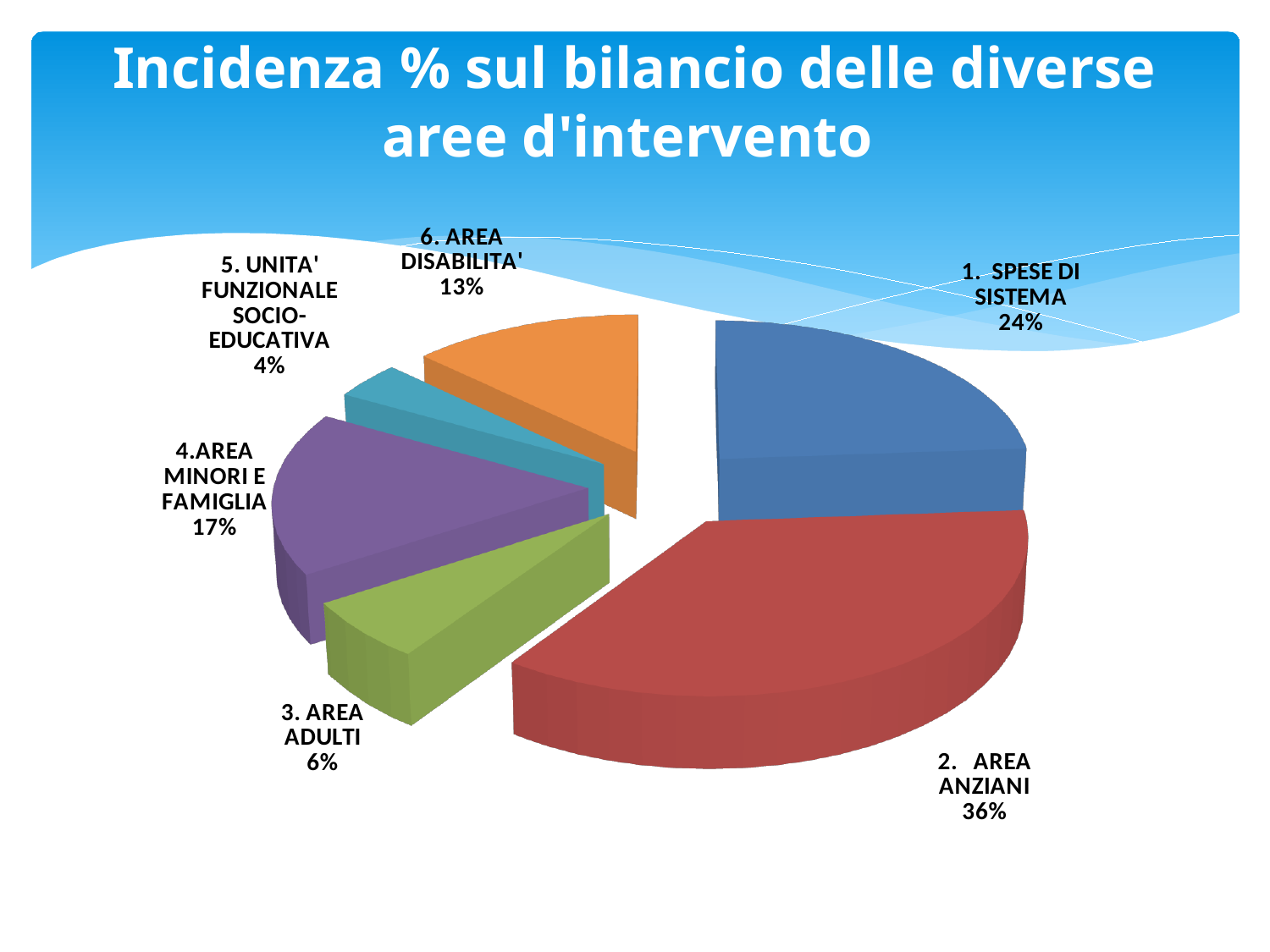
What percentage is shown for '5. UNITA' FUNZIONALE SOCIO-EDUCATIVA'? 4% What kind of chart is shown on the slide? Pie chart What percentage is shown for '4.AREA MINORI E FAMIGLIA'? 17% How many slices does the pie chart have? 6 What share of the budget does '1. SPESE DI SISTEMA' account for? 24% What is the title of the slide? Incidenza % sul bilancio delle diverse aree d'intervento What is the difference in percentage points between '2. AREA ANZIANI' and '1. SPESE DI SISTEMA'? 12 Which area has the smallest share of the budget? 5. UNITA' FUNZIONALE SOCIO-EDUCATIVA Which area has the largest share of the budget? 2. AREA ANZIANI What share of the budget does '2. AREA ANZIANI' account for? 36% What percentage is shown for '6. AREA DISABILITA''? 13% Which has a larger share: '4.AREA MINORI E FAMIGLIA' or '6. AREA DISABILITA''? 4.AREA MINORI E FAMIGLIA